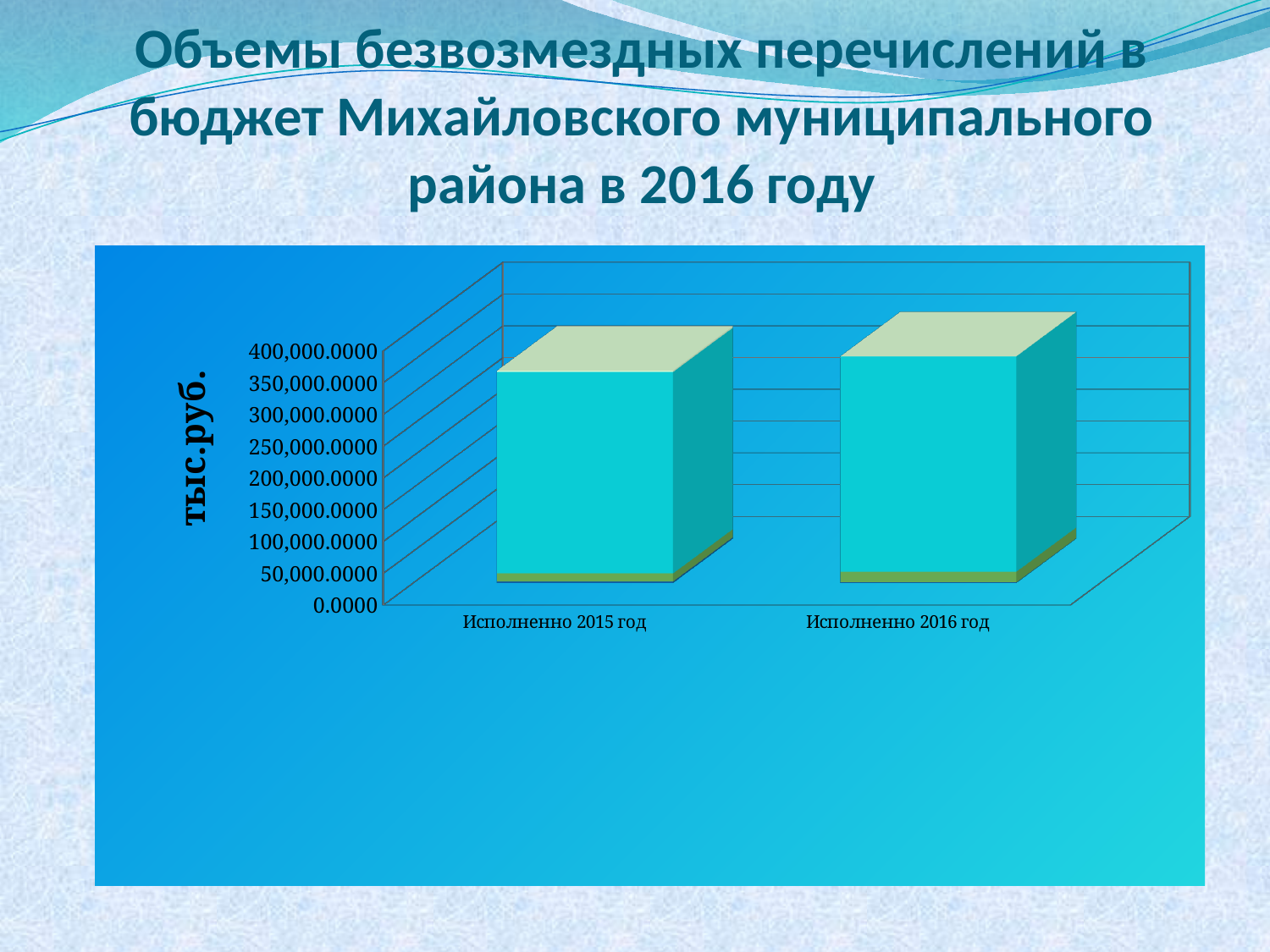
Which category has the higher bar, Исполненно 2015 год or Исполненно 2016 год? Исполненно 2016 год Which category has the highest value in the chart? Исполненно 2016 год What kind of chart is shown on the slide? bar chart Is the value for Исполненно 2016 год greater or less than 250,000.0000? greater Is the value for Исполненно 2015 год greater or less than 400,000.0000? less Which category has the lowest value in the chart? Исполненно 2015 год How many categories are plotted on the x axis of the chart? 2 Is the value for Исполненно 2015 год greater or less than 300,000.0000? greater What is the highest tick value shown on the vertical axis of the chart? 400,000.0000 What is the title of the vertical axis of the chart? тыс.руб. Do the values rise or fall from Исполненно 2015 год to Исполненно 2016 год? rise